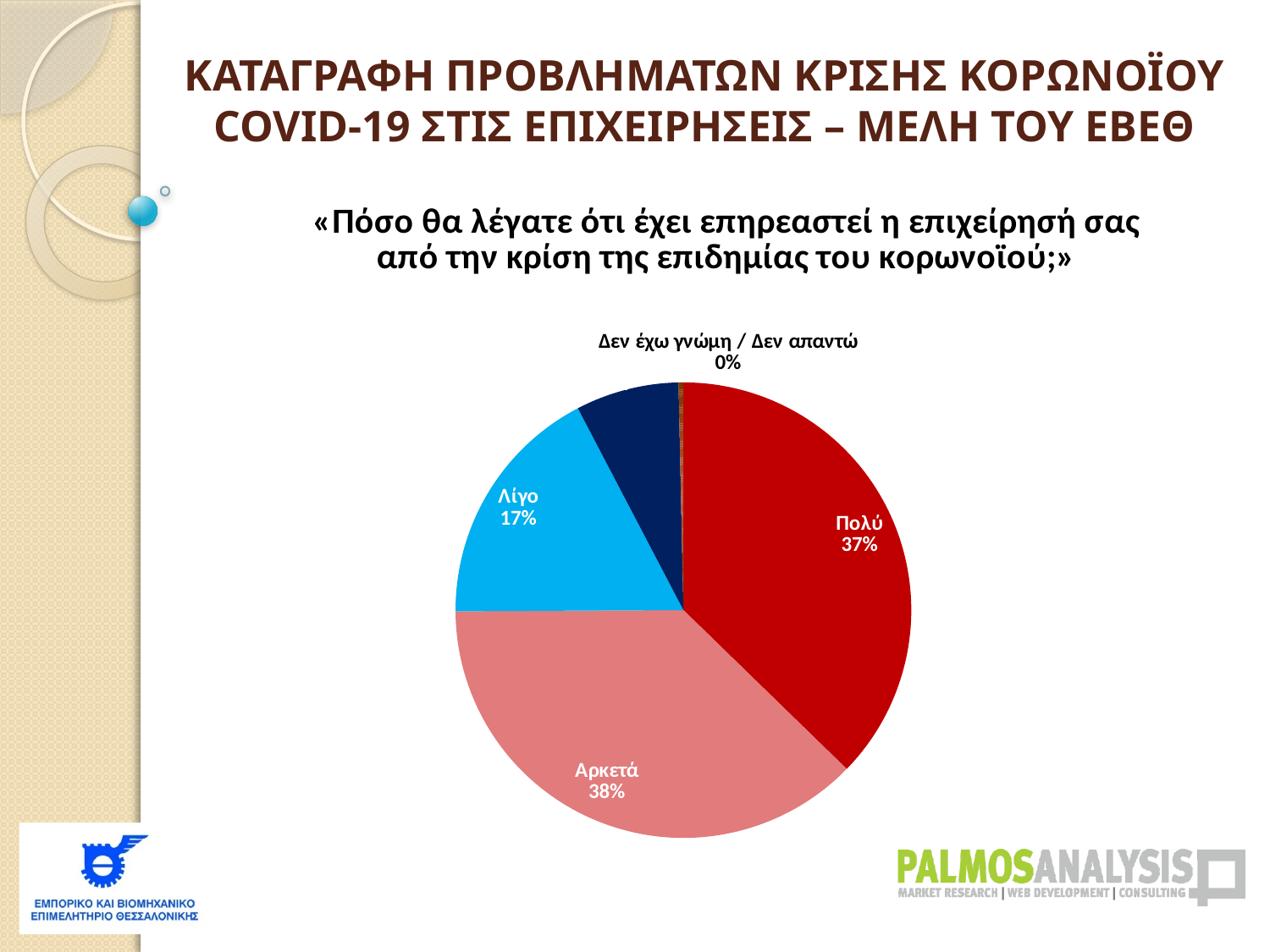
Which labelled response has the smallest share of the pie? Δεν έχω γνώμη / Δεν απαντώ What kind of chart is shown on the slide? Pie chart Which is larger, the share for «Αρκετά» or the share for «Λίγο»? Αρκετά What colour is the «Λίγο» slice of the pie? Light blue Which is larger, the share for «Πολύ» or the share for «Λίγο»? Πολύ What percentage is shown for «Δεν έχω γνώμη / Δεν απαντώ»? 0% What colour is the «Πολύ» slice of the pie? Red What percentage of respondents answered «Αρκετά»? 38% What is the difference in percentage points between «Αρκετά» and «Λίγο»? 21 What is the difference in percentage points between «Πολύ» and «Λίγο»? 20 What percentage of respondents answered «Πολύ»? 37% What percentage of respondents answered «Λίγο»? 17%